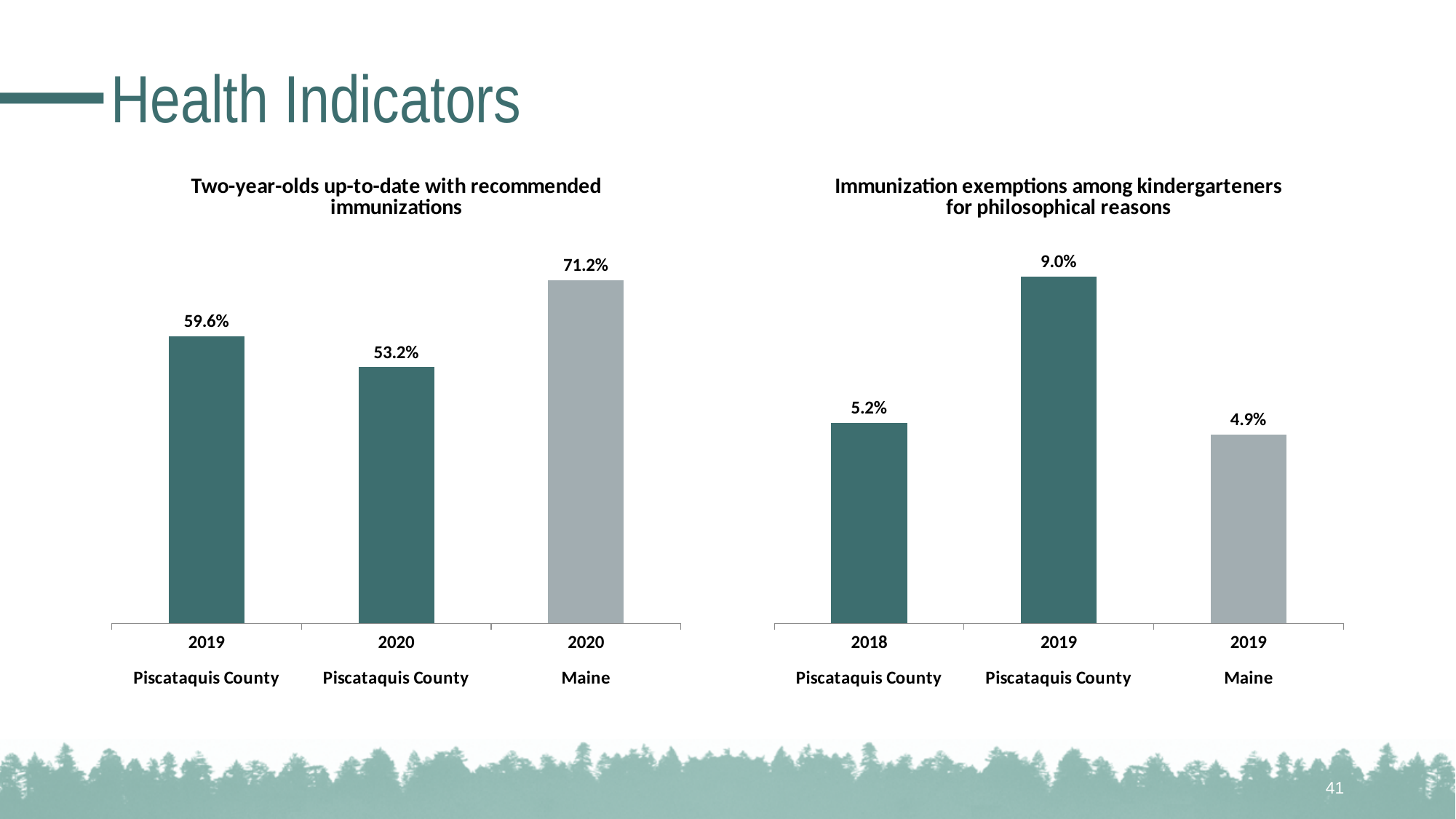
In the 'Two-year-olds up-to-date with recommended immunizations' chart, what is the difference between Maine 2020 and Piscataquis County 2020? 18.0% In the 'Immunization exemptions among kindergarteners for philosophical reasons' chart, what is the difference between Piscataquis County 2019 and Piscataquis County 2018? 3.8% In the 'Two-year-olds up-to-date with recommended immunizations' chart, what is the value for Piscataquis County in 2019? 59.6% In the 'Immunization exemptions among kindergarteners for philosophical reasons' chart, what is the value for Piscataquis County in 2019? 9.0% What kind of chart is the 'Two-year-olds up-to-date with recommended immunizations' chart? Bar chart In the 'Immunization exemptions among kindergarteners for philosophical reasons' chart, which is larger: Piscataquis County 2018 or Maine 2019? Piscataquis County 2018 In the 'Two-year-olds up-to-date with recommended immunizations' chart, which bar is the lowest? Piscataquis County 2020 In the 'Two-year-olds up-to-date with recommended immunizations' chart, how many bars are plotted? 3 In the 'Immunization exemptions among kindergarteners for philosophical reasons' chart, which bar is the highest? Piscataquis County 2019 In the 'Immunization exemptions among kindergarteners for philosophical reasons' chart, what colour is the Maine bar? Grey In the 'Immunization exemptions among kindergarteners for philosophical reasons' chart, what is the value for Maine in 2019? 4.9% In the 'Two-year-olds up-to-date with recommended immunizations' chart, what is the value for Maine in 2020? 71.2%